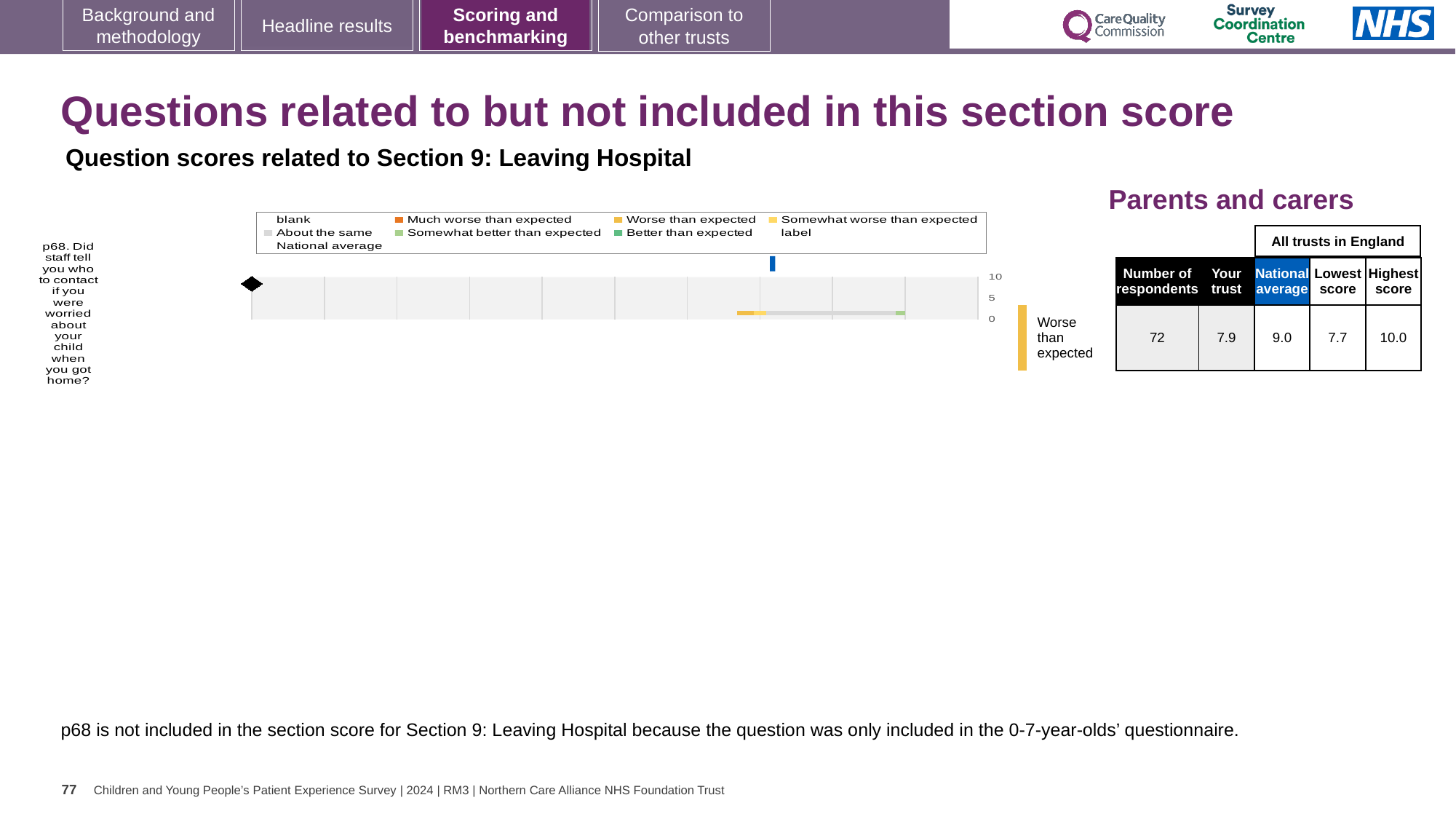
What benchmark category label is shown next to the chart for question p68? Worse than expected What is the highest score among all trusts in England for question p68? 10.0 What is the national average score shown for question p68? 9.0 How many questions are plotted on the chart? 1 What is the difference between the highest and lowest trust scores for question p68? 2.3 What is the difference between the national average and the 'Your trust' score for question p68? 1.1 Which is larger for question p68: the 'Your trust' score or the national average? National average How many respondents answered question p68? 72 What is the lowest score among all trusts in England for question p68? 7.7 What is the 'Your trust' score for question p68 on the chart? 7.9 Is the 'Your trust' score for question p68 greater or less than 5? greater Which respondent group does the chart cover, according to the heading above the table? Parents and carers